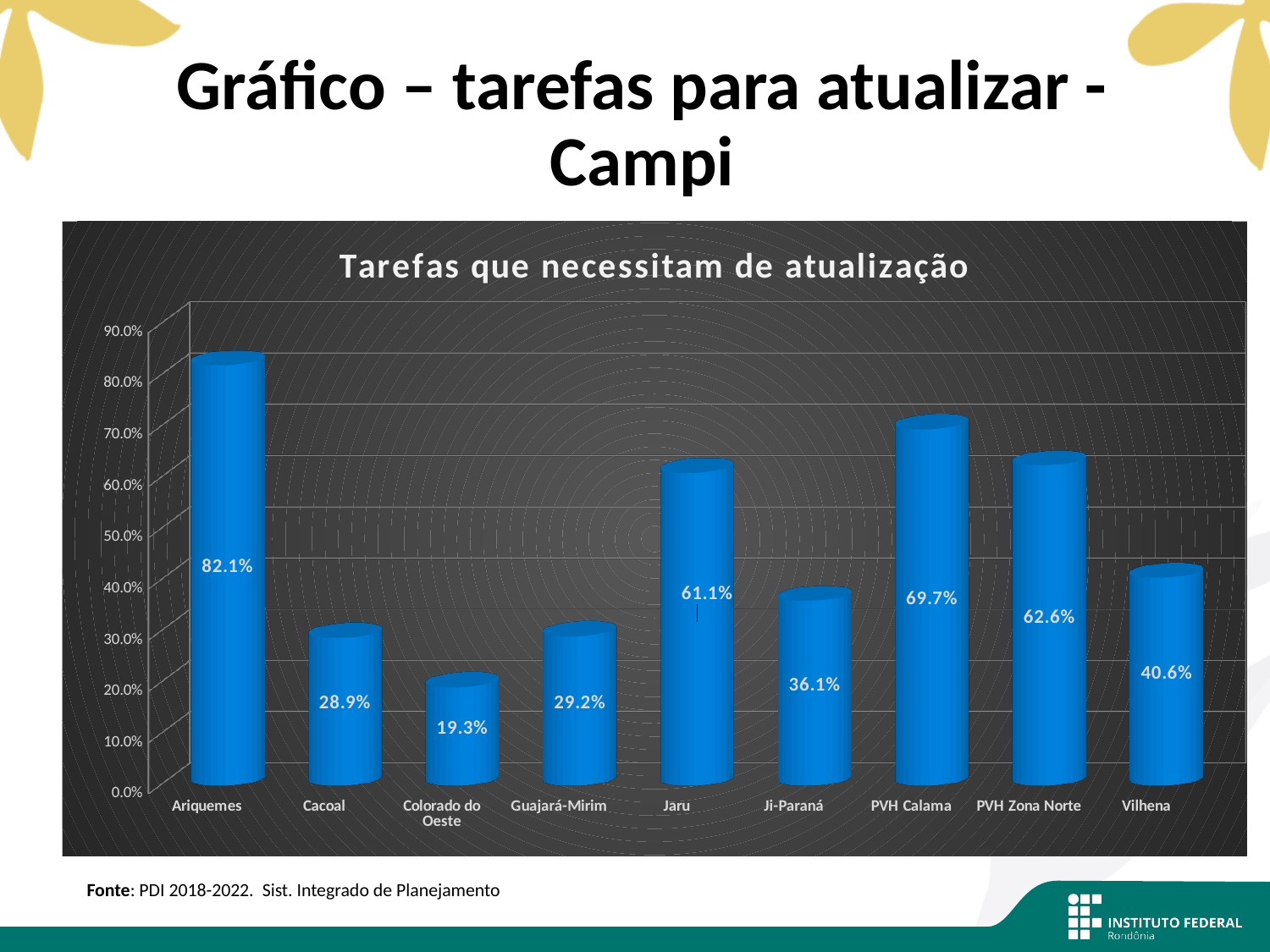
What is the difference between the values for Guajará-Mirim and Cacoal? 0.3% How many campuses are shown on the chart? 9 What is the difference between the values for PVH Calama and Jaru? 8.6% What is the value for Ariquemes? 82.1% What is the value for Colorado do Oeste? 19.3% What is the title of the chart? Tarefas que necessitam de atualização Which campus has the highest value? Ariquemes Which campus has the lowest value? Colorado do Oeste Is the value for Cacoal greater or less than 30.0%? less What kind of chart is shown? bar chart What is the value for PVH Zona Norte? 62.6% Which is larger, the value for Vilhena or the value for Ji-Paraná? Vilhena